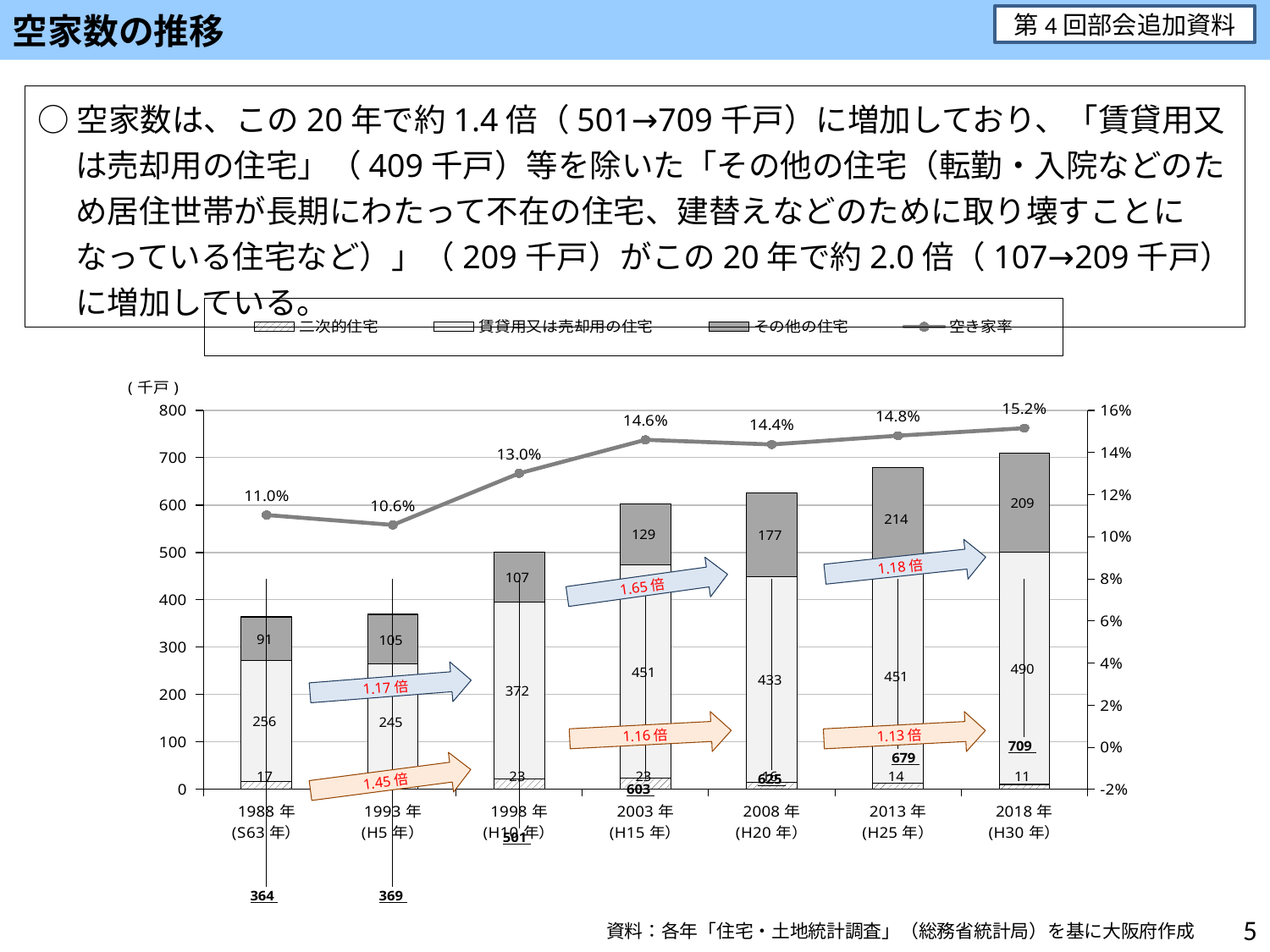
Which year has the highest 空き家率? 2018年 (H30年) What is the total of the stacked bar for 2013年 (H25年)? 679 How many series does the legend list? 4 Which year has the lowest 空き家率? 1993年 (H5年) What is the 空き家率 for 2003年 (H15年)? 14.6% Which is larger, 賃貸用又は売却用の住宅 in 2008年 (H20年) or in 2018年 (H30年)? 2018年 (H30年) What is the difference in その他の住宅 between 2013年 (H25年) and 1998年 (H10年)? 107 How many years (categories) are shown on the x axis? 7 What is the value of 賃貸用又は売却用の住宅 for 1998年 (H10年)? 372 What is the value of その他の住宅 for 2018年 (H30年)? 209 What type of chart is shown on the slide? Stacked bar chart with a line Does the total number of vacant houses generally rise or fall from 1988年 to 2018年? Rise